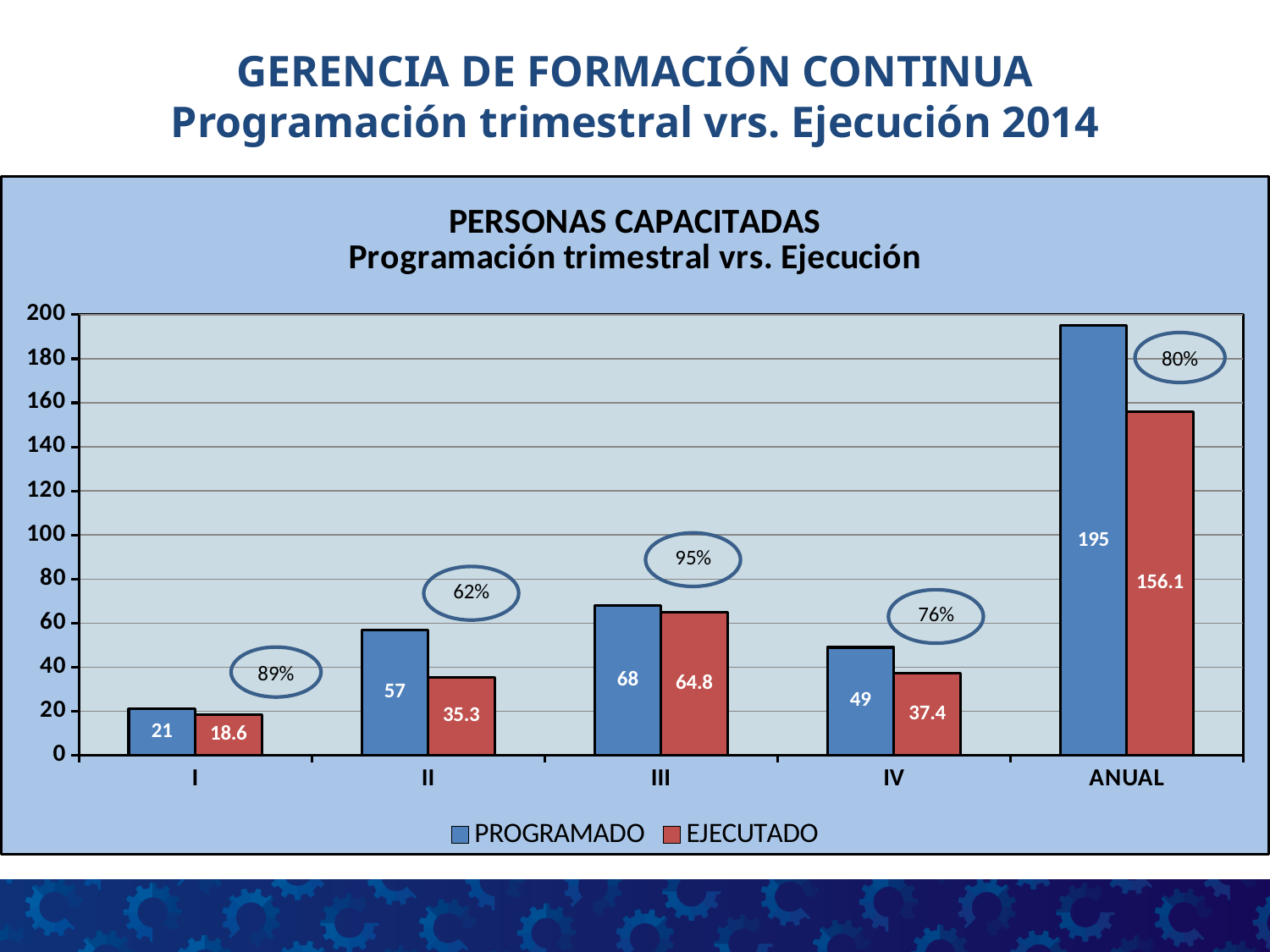
What is the EJECUTADO value for ANUAL? 156.1 Which category has the lowest EJECUTADO value? I Which category has the highest PROGRAMADO value? ANUAL What is the PROGRAMADO value for quarter II? 57 Which is larger for quarter II: PROGRAMADO or EJECUTADO? PROGRAMADO What is the EJECUTADO value for quarter III? 64.8 What is the difference between PROGRAMADO and EJECUTADO for quarter IV? 11.6 How many categories are shown on the x axis? 5 How many series does the legend list? 2 What colour are the EJECUTADO bars? Red What percentage is shown in the circle above quarter III? 95% What kind of chart is shown? Bar chart